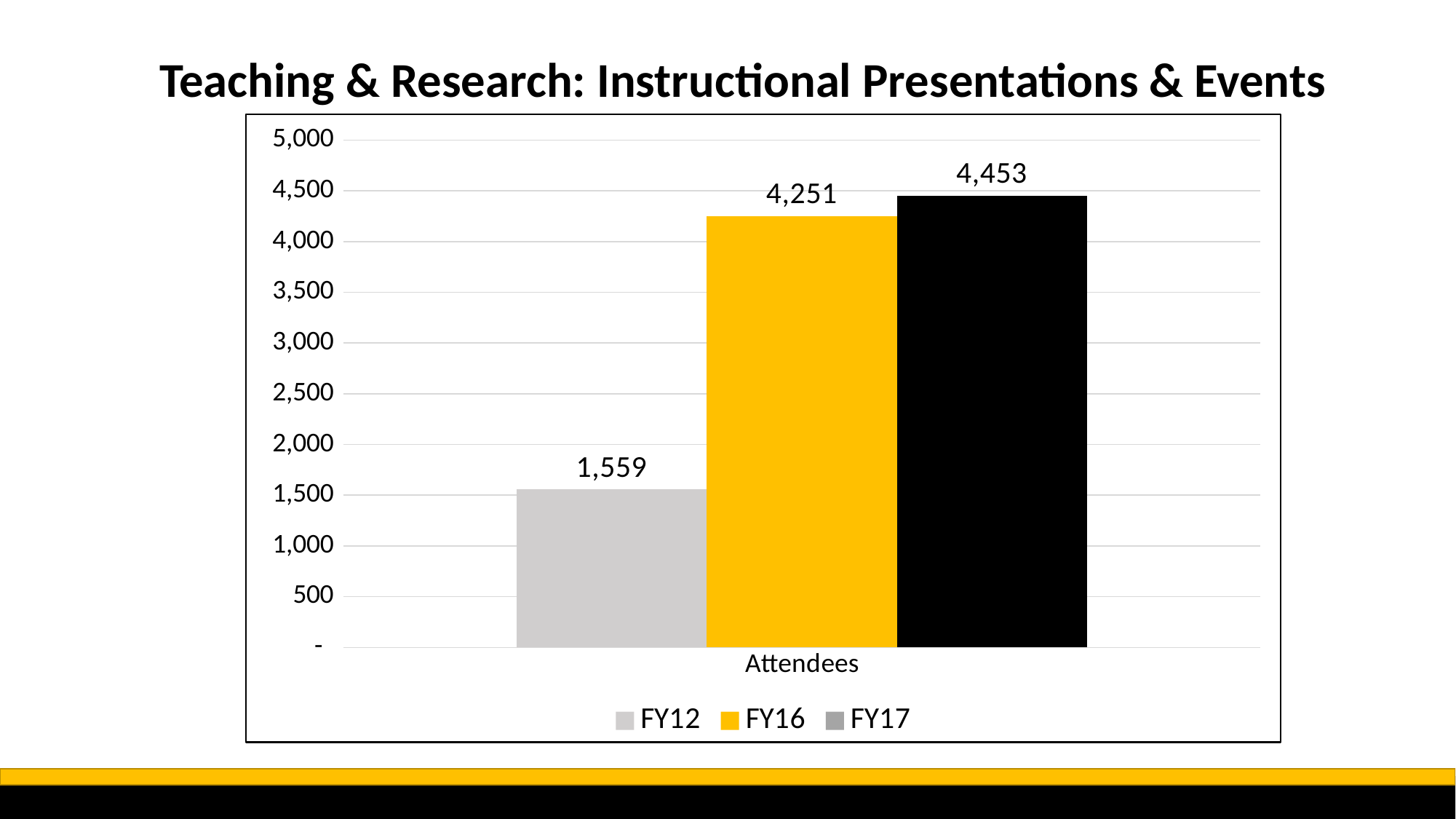
How many series does the legend list? 3 What is the title of the chart on the slide? Teaching & Research: Instructional Presentations & Events Is the value for FY12 attendees greater or less than 2,000? less What is the number of attendees for FY12? 1,559 What kind of chart is shown on the slide? Bar chart What is the difference in attendees between FY17 and FY16? 202 Which fiscal year has the lowest number of attendees? FY12 Which fiscal year has the highest number of attendees? FY17 Which has more attendees, FY12 or FY16? FY16 What is the number of attendees for FY16? 4,251 What is the difference in attendees between FY16 and FY12? 2,692 What is the number of attendees for FY17? 4,453